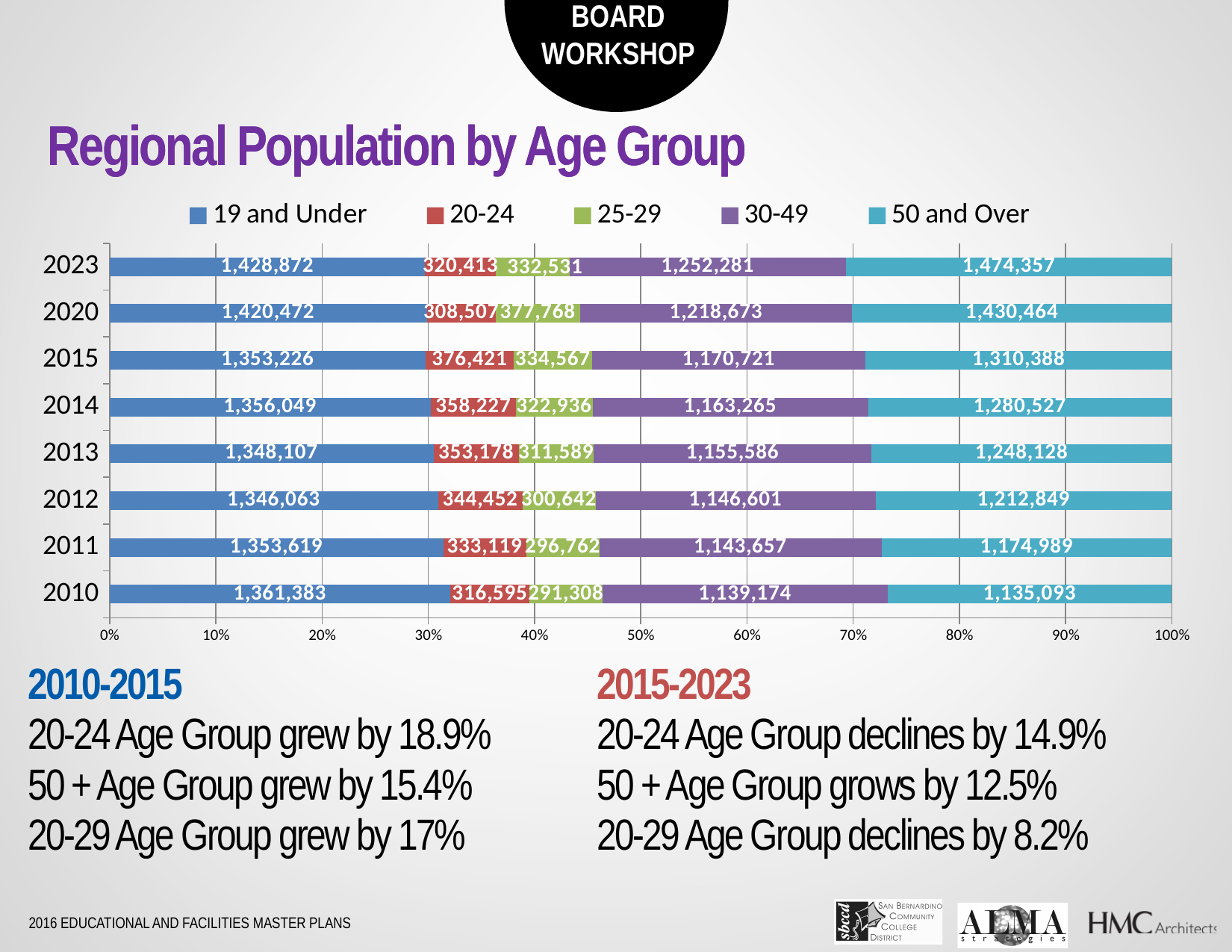
What is the difference between the 50 and Over values in 2023 and 2010? 339,264 How many age groups does the legend list? 5 What is the value for the 19 and Under group in 2015? 1,353,226 How many years are shown on the chart? 8 What is the value for the 30-49 group in 2023? 1,252,281 Which year has the highest value for the 50 and Over group? 2023 Which year has the lowest value for the 25-29 group? 2010 What kind of chart is shown on the slide? Stacked bar chart What is the value for the 50 and Over group in 2010? 1,135,093 What is the title of the chart? Regional Population by Age Group Which is larger, the 20-24 value in 2015 or in 2023? 2015 Does the value for the 50 and Over group rise or fall from 2010 to 2023? Rises